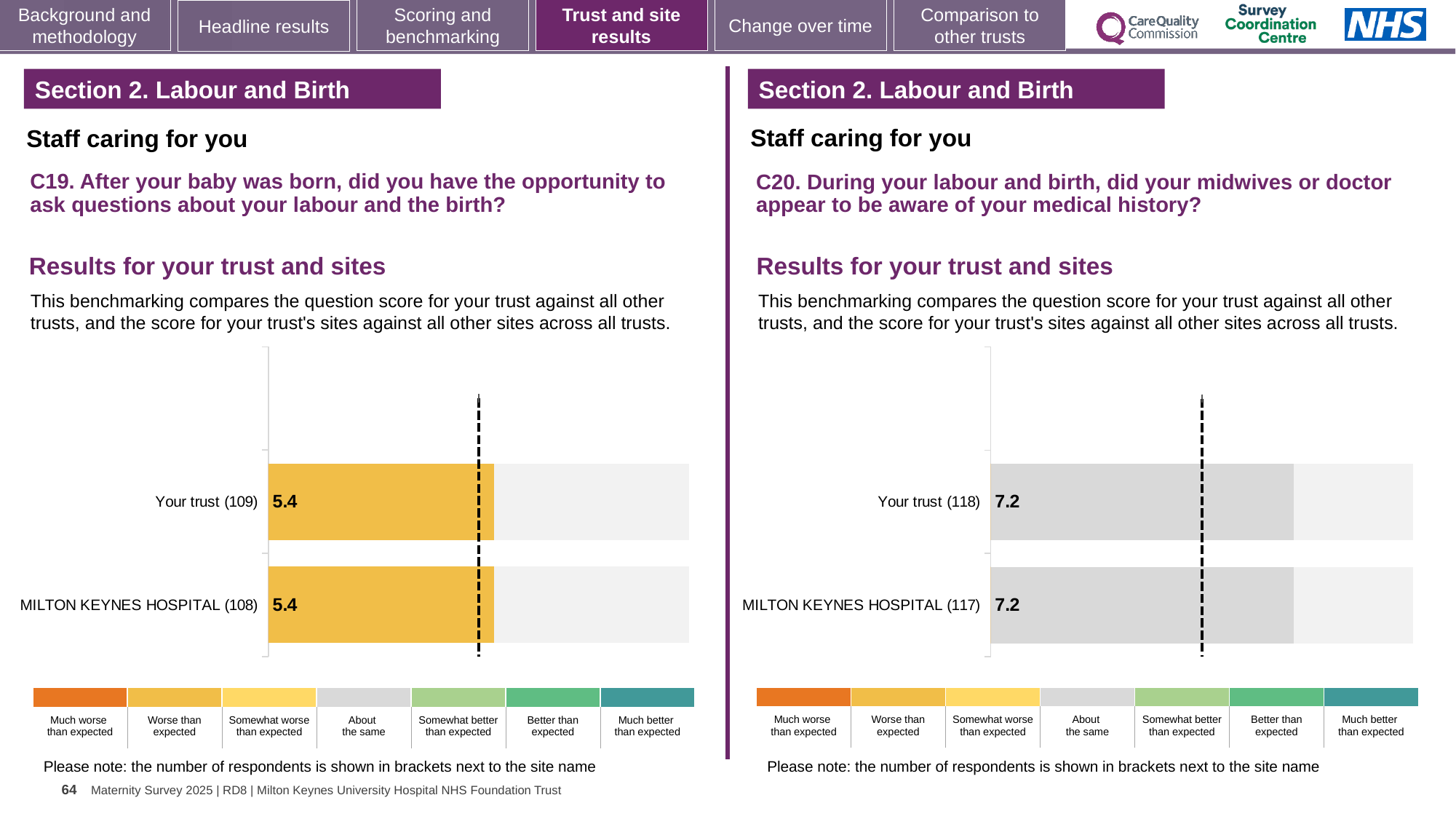
In the right chart (C20), what is the score for MILTON KEYNES HOSPITAL? 7.2 What type of chart is used in the left chart (C19)? Bar chart In the left chart (C19), how many respondents are shown in brackets for Your trust? 109 In the left chart (C19), what is the score for Your trust? 5.4 In the right chart (C20), how many respondents are shown in brackets for MILTON KEYNES HOSPITAL? 117 In the left chart (C19), what is the difference between the score for Your trust and the score for MILTON KEYNES HOSPITAL? 0.0 How many bars are plotted in the left chart (C19)? 2 How many bars are plotted in the right chart (C20)? 2 In the right chart (C20), what is the difference between the score for Your trust and the score for MILTON KEYNES HOSPITAL? 0.0 In the left chart (C19), what is the score for MILTON KEYNES HOSPITAL? 5.4 In the right chart (C20), what is the score for Your trust? 7.2 According to the colour key, which benchmark category do the bars in the right chart (C20) fall into? About the same